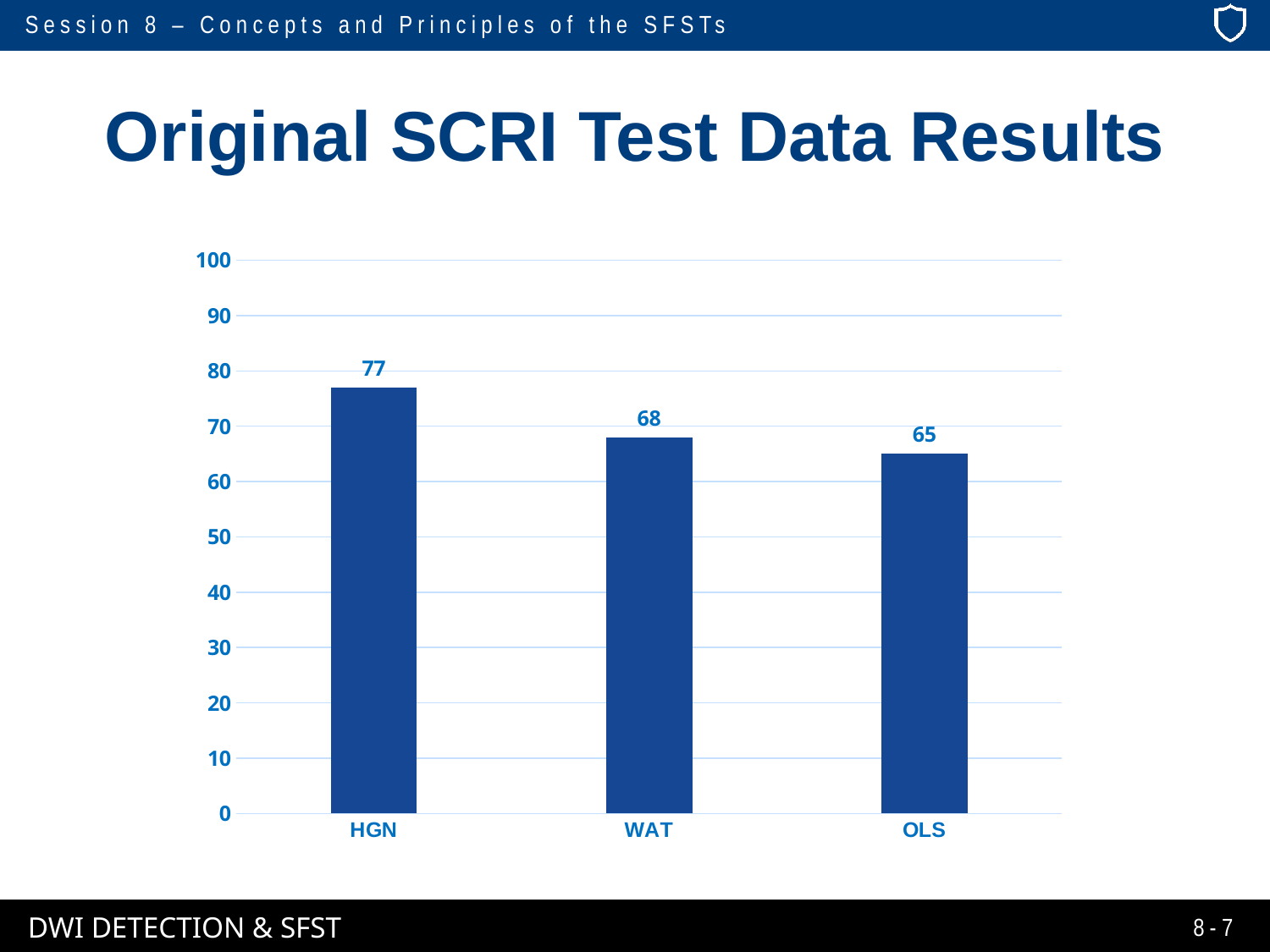
Is the value for WAT greater or less than 70? less What is the difference between the values for WAT and OLS? 3 How many categories are shown on the x axis? 3 Which category has the lowest value? OLS Which category has the highest value? HGN Which is larger, the value for HGN or the value for OLS? HGN What is the difference between the values for HGN and WAT? 9 What is the value for WAT? 68 Do the values rise or fall from left to right along the x axis? fall What is the value for HGN? 77 What is the value for OLS? 65 What kind of chart is shown on the slide? bar chart